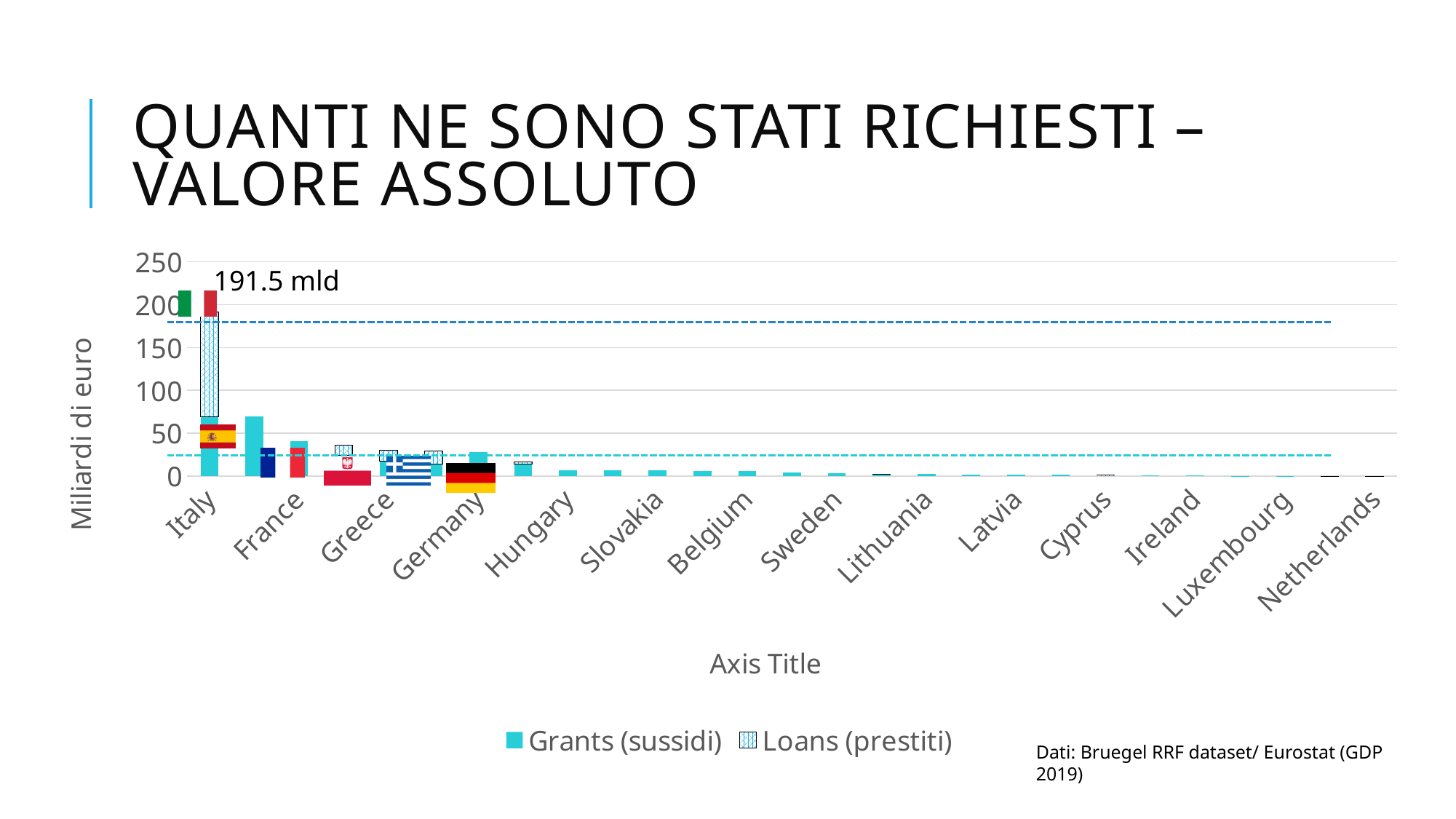
Is the total value for Italy greater or less than 150? greater Do the total bar values rise or fall from left to right along the x axis? Fall Is the total value for Hungary greater or less than 50? less What kind of chart is shown on the slide? Bar chart What is the total value shown for Italy? 191.5 mld Is the total value for Germany greater or less than 100? less Which has a larger total bar, Italy or France? Italy Which has a larger total bar, Greece or Netherlands? Greece How many series does the legend list? 2 What is the title of the vertical axis? Miliardi di euro Which country has the highest total bar? Italy